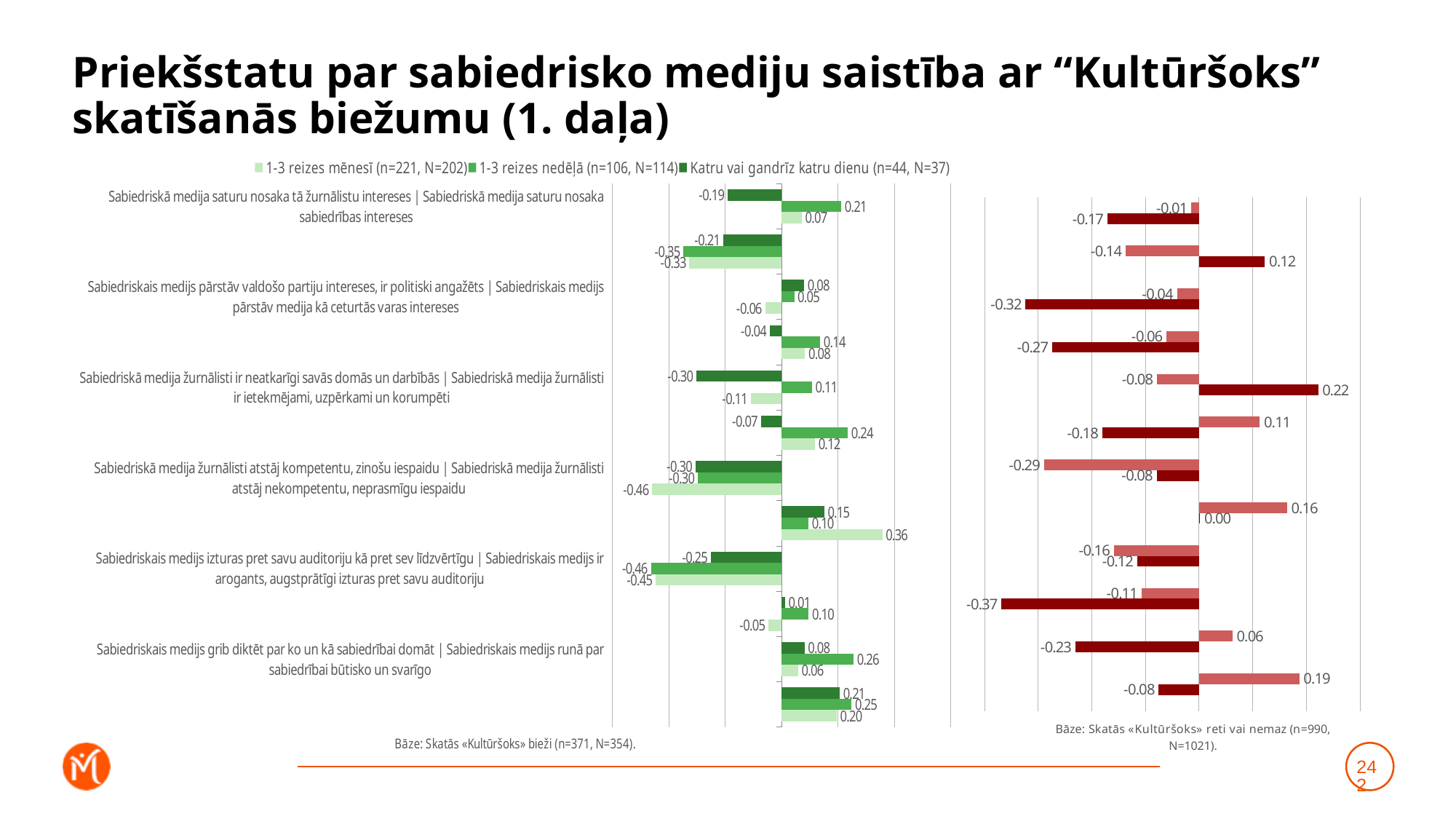
In the left (green) chart, what is the value for "Katru vai gandrīz katru dienu" in the top category ("Sabiedriskā medija saturu nosaka tā žurnālistu intereses | Sabiedriskā medija saturu nosaka sabiedrības intereses")? -0.19 What is the highest value labelled anywhere in the left (green) chart? 0.36 How many series does the legend of the left (green) chart list? 3 In the left (green) chart, for the top category, which is larger: the value for "1-3 reizes nedēļā" or for "1-3 reizes mēnesī"? 1-3 reizes nedēļā What is the highest value labelled anywhere in the right (red) chart? 0.22 What kind of chart is the left (green) chart on the slide? bar chart In the left (green) chart, what is the value for "1-3 reizes mēnesī" in the top category ("Sabiedriskā medija saturu nosaka tā žurnālistu intereses | ...")? 0.07 What is the lowest value labelled anywhere in the right (red) chart? -0.37 In the left (green) chart, for the top category, what is the difference between the "1-3 reizes nedēļā" value and the "Katru vai gandrīz katru dienu" value? 0.40 In the left (green) chart, what is the value for "1-3 reizes nedēļā" in the top category ("Sabiedriskā medija saturu nosaka tā žurnālistu intereses | ...")? 0.21 In the left (green) chart, what are the three legend entries? 1-3 reizes mēnesī (n=221, N=202); 1-3 reizes nedēļā (n=106, N=114); Katru vai gandrīz katru dienu (n=44, N=37) According to the base note under the left (green) chart, what is the n for "Skatās «Kultūršoks» bieži"? 371